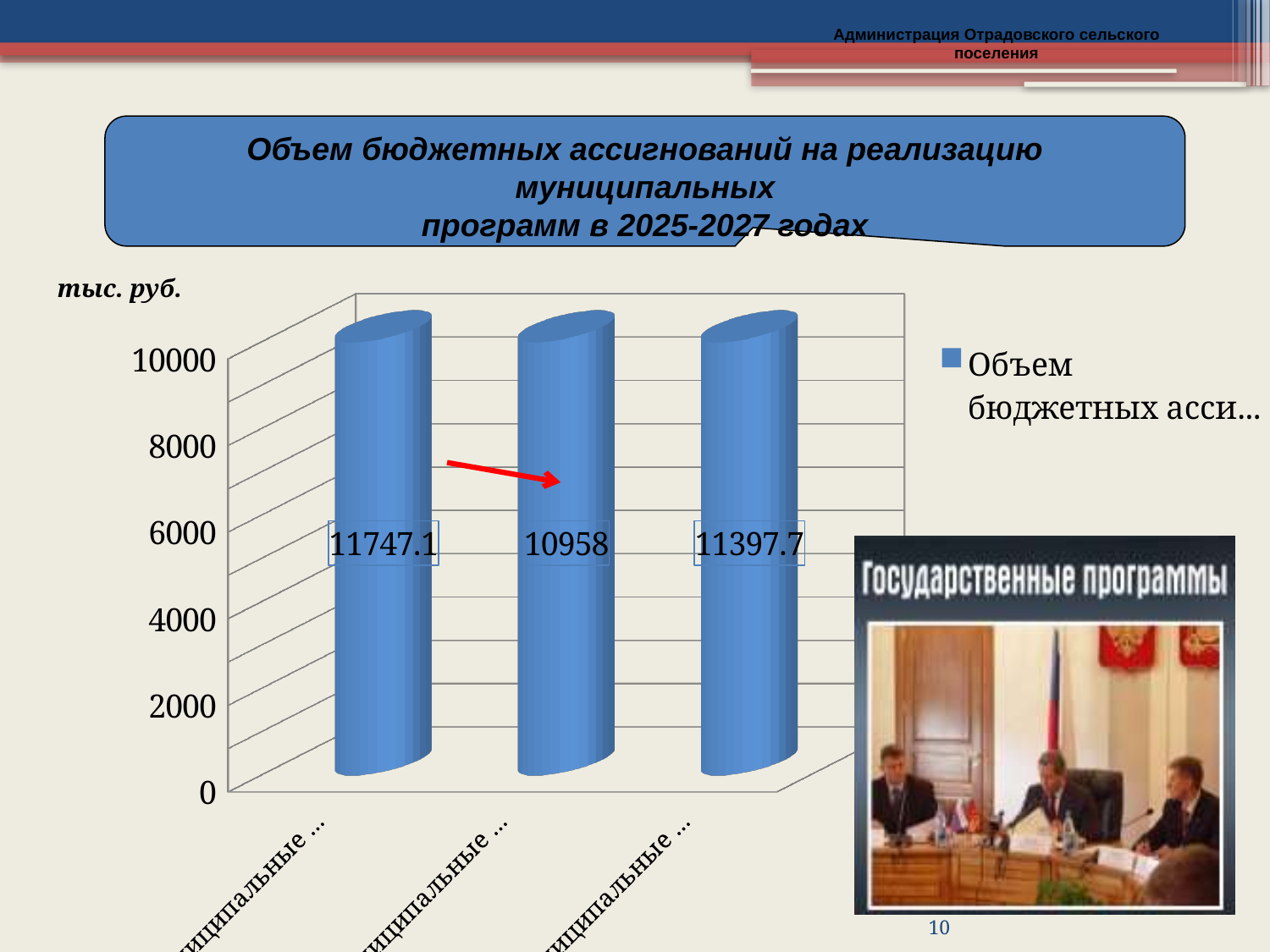
How many bars are plotted in the chart? 3 Which is larger: the value of the leftmost bar or the value of the rightmost bar? the leftmost bar Is the value of the middle bar greater or less than 10000? greater How many series does the chart legend list? 1 Which bar has the highest value: the left, middle or right one? the left one What type of chart is shown on the slide? bar chart What is the value of the leftmost bar in the chart? 11747.1 What is the value of the rightmost bar in the chart? 11397.7 Which bar has the lowest value: the left, middle or right one? the middle one What is the difference between the rightmost bar (11397.7) and the middle bar (10958)? 439.7 What is the value of the middle bar in the chart? 10958 What is the difference between the leftmost bar (11747.1) and the middle bar (10958)? 789.1